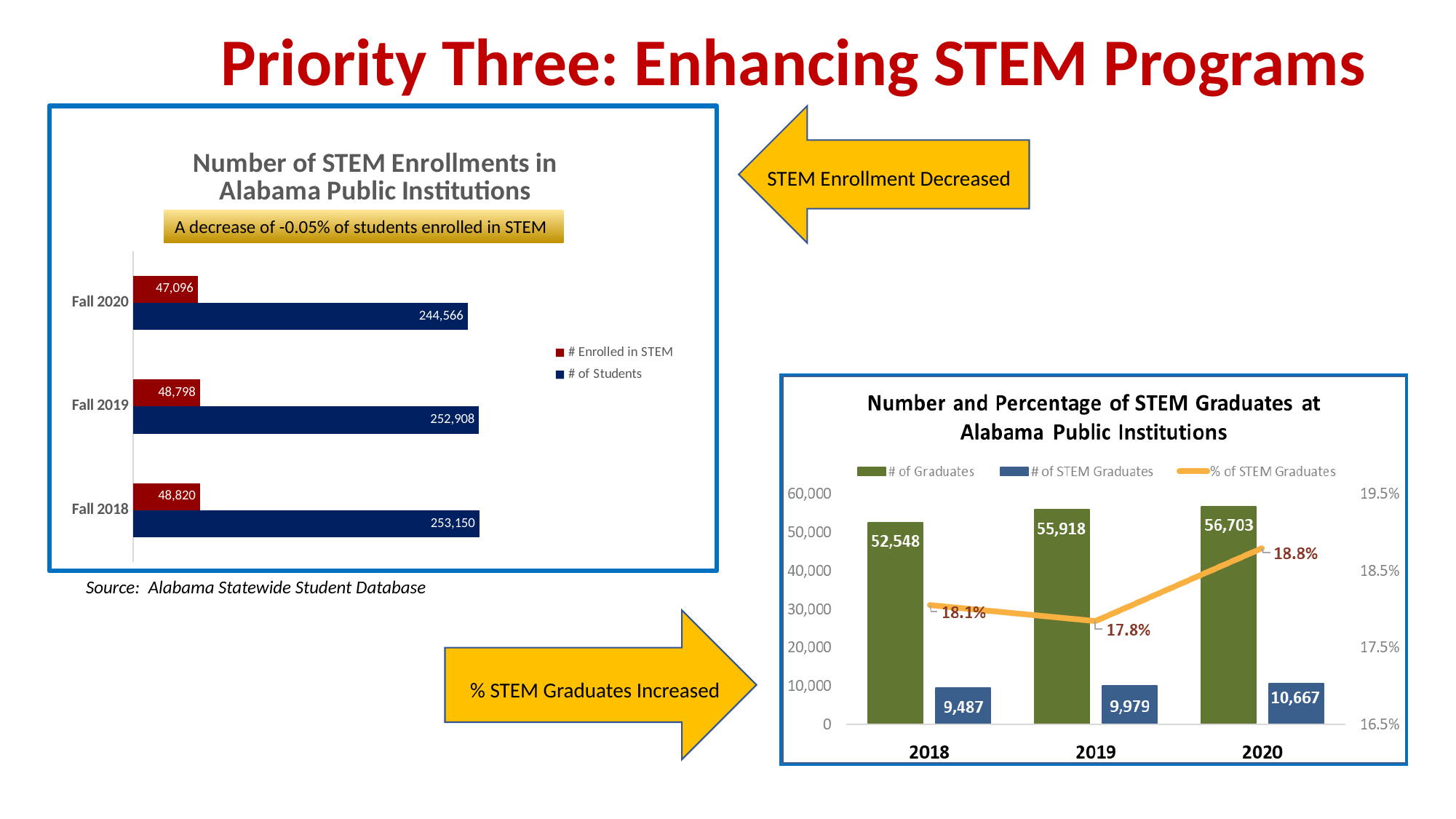
What kind of chart is the 'Number of STEM Enrollments in Alabama Public Institutions' chart? Bar chart In the 'Number and Percentage of STEM Graduates at Alabama Public Institutions' chart, what is the number of STEM graduates in 2019? 9,979 In the 'Number and Percentage of STEM Graduates at Alabama Public Institutions' chart, what is the percentage of STEM graduates in 2020? 18.8% In the 'Number and Percentage of STEM Graduates at Alabama Public Institutions' chart, is the percentage of STEM graduates higher in 2018 or 2019? 2018 In the 'Number and Percentage of STEM Graduates at Alabama Public Institutions' chart, how many years are shown on the x axis? 3 In the 'Number of STEM Enrollments in Alabama Public Institutions' chart, what is the number enrolled in STEM for Fall 2020? 47,096 In the 'Number and Percentage of STEM Graduates at Alabama Public Institutions' chart, what is the difference in the number of STEM graduates between 2020 and 2018? 1,180 In the 'Number of STEM Enrollments in Alabama Public Institutions' chart, how many series does the legend list? 2 In the 'Number and Percentage of STEM Graduates at Alabama Public Institutions' chart, which year has the highest number of graduates? 2020 In the 'Number of STEM Enrollments in Alabama Public Institutions' chart, what is the number of students for Fall 2018? 253,150 In the 'Number of STEM Enrollments in Alabama Public Institutions' chart, what is the difference in the number of students between Fall 2019 and Fall 2020? 8,342 In the 'Number of STEM Enrollments in Alabama Public Institutions' chart, which term has the lowest number enrolled in STEM? Fall 2020